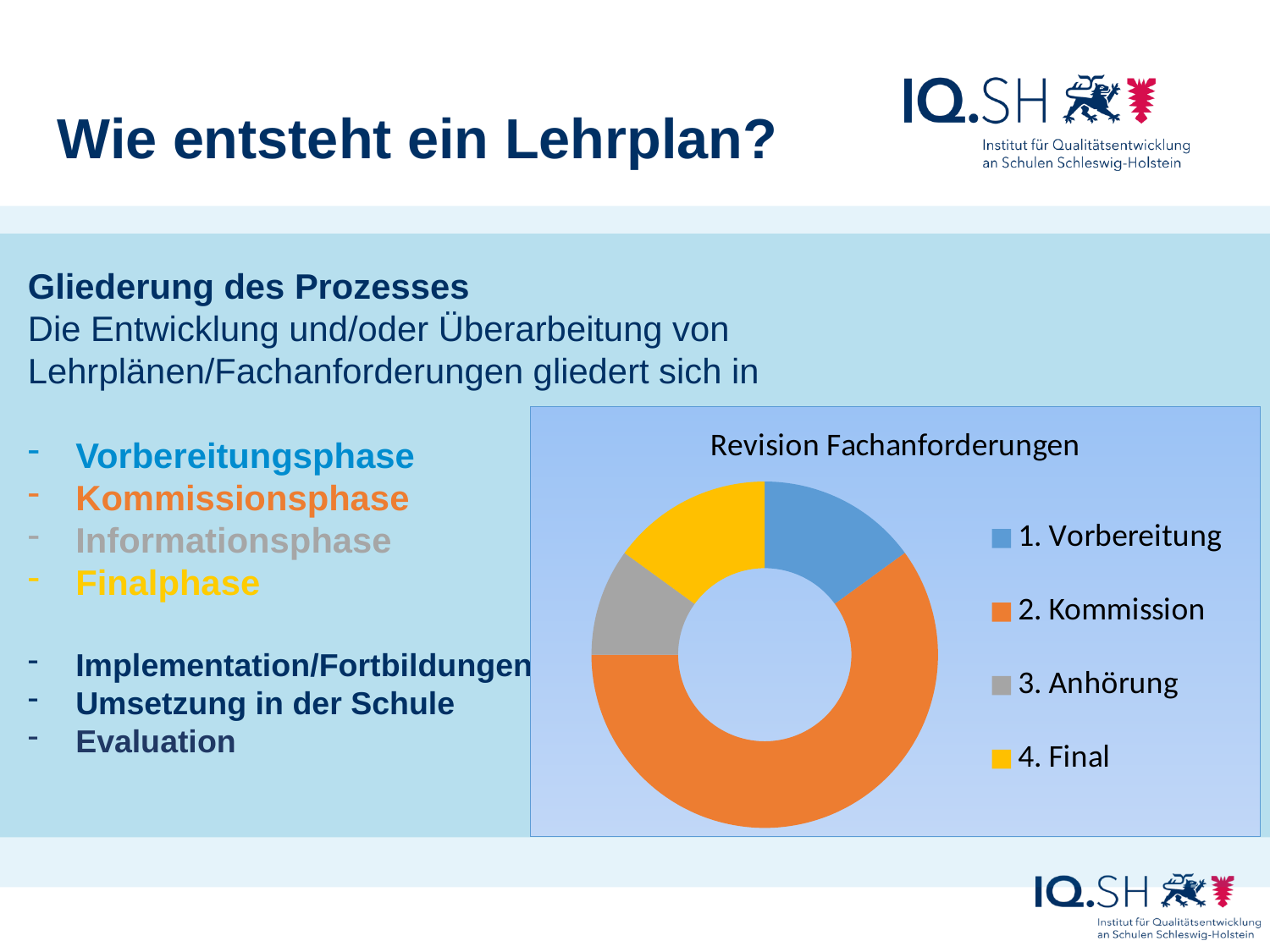
What kind of chart is shown on the slide? Doughnut chart Which category has the largest share of the chart? 2. Kommission What is the title of the chart on the slide? Revision Fachanforderungen Which category is shown in orange in the chart? 2. Kommission Which is larger in the chart, 2. Kommission or 4. Final? 2. Kommission How many categories does the chart show? 4 Which category is listed first in the chart legend? 1. Vorbereitung Which colour represents 3. Anhörung in the chart? Gray Which is larger in the chart, 2. Kommission or 3. Anhörung? 2. Kommission Which category is listed last in the chart legend? 4. Final Which is larger in the chart, 2. Kommission or 1. Vorbereitung? 2. Kommission